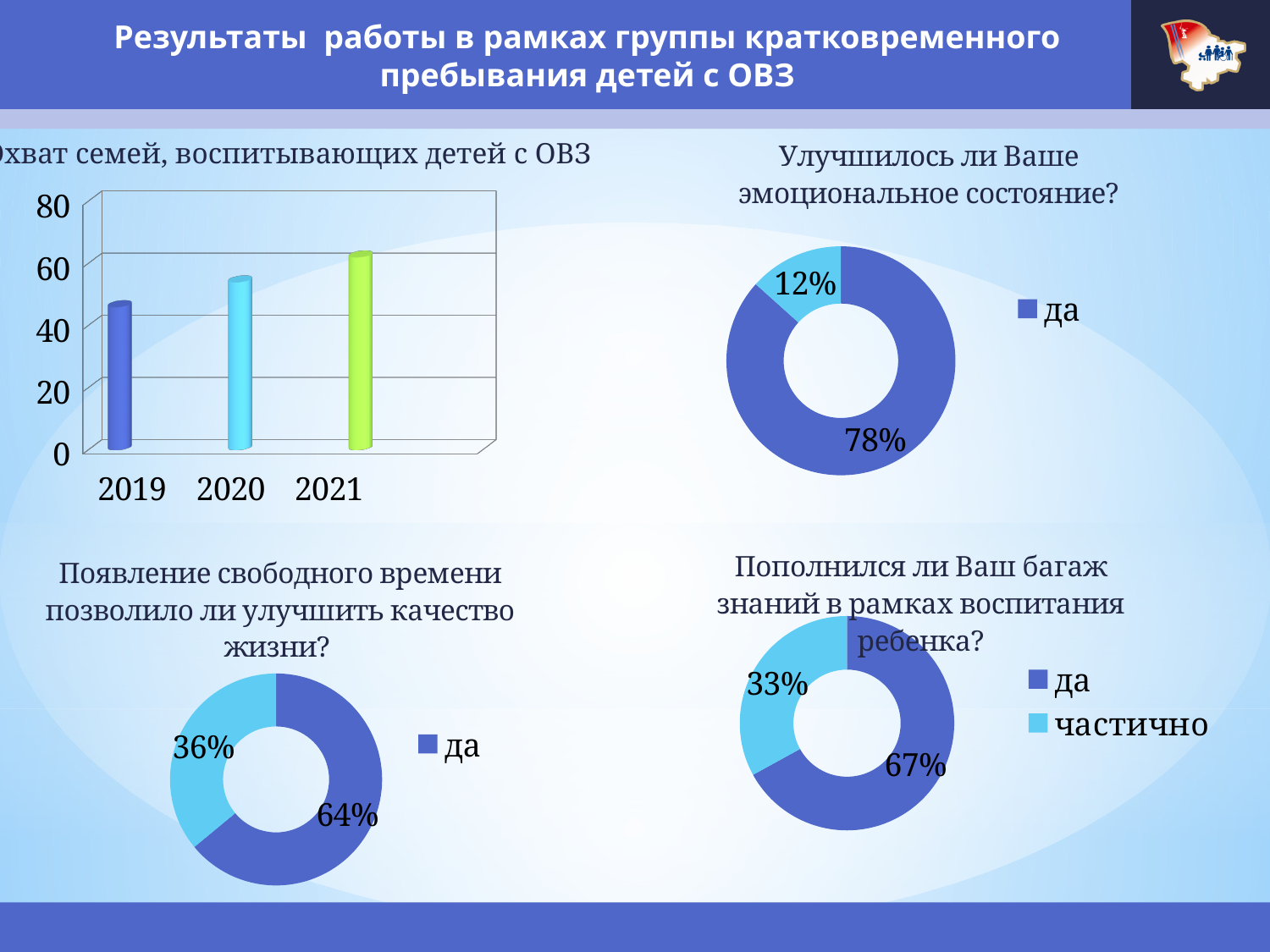
In the top-left bar chart 'Охват семей, воспитывающих детей с ОВЗ', which year has the lowest bar? 2019 In the top-left bar chart 'Охват семей, воспитывающих детей с ОВЗ', is the value for 2019 greater or less than 40? greater What kind of chart is the top-left chart titled 'Охват семей, воспитывающих детей с ОВЗ'? bar chart How many entries does the legend of the bottom-right doughnut chart 'Пополнился ли Ваш багаж знаний в рамках воспитания ребенка?' list? 2 In the top-left bar chart 'Охват семей, воспитывающих детей с ОВЗ', do the values rise or fall from 2019 to 2021? rise In the top-left bar chart 'Охват семей, воспитывающих детей с ОВЗ', is the value for 2020 greater or less than 60? less In the bottom-left doughnut chart 'Появление свободного времени позволило ли улучшить качество жизни?', what is the difference between the two labelled slices (64% and 36%)? 28% In the bottom-right doughnut chart 'Пополнился ли Ваш багаж знаний в рамках воспитания ребенка?', what share is labelled for 'частично'? 33% How many years are shown on the x axis of the top-left bar chart 'Охват семей, воспитывающих детей с ОВЗ'? 3 In the top-right doughnut chart 'Улучшилось ли Ваше эмоциональное состояние?', what percentage is shown on the smaller light-blue slice? 12% In the top-left bar chart 'Охват семей, воспитывающих детей с ОВЗ', which year has the highest bar? 2021 In the top-right doughnut chart 'Улучшилось ли Ваше эмоциональное состояние?', what share is labelled for 'да'? 78%